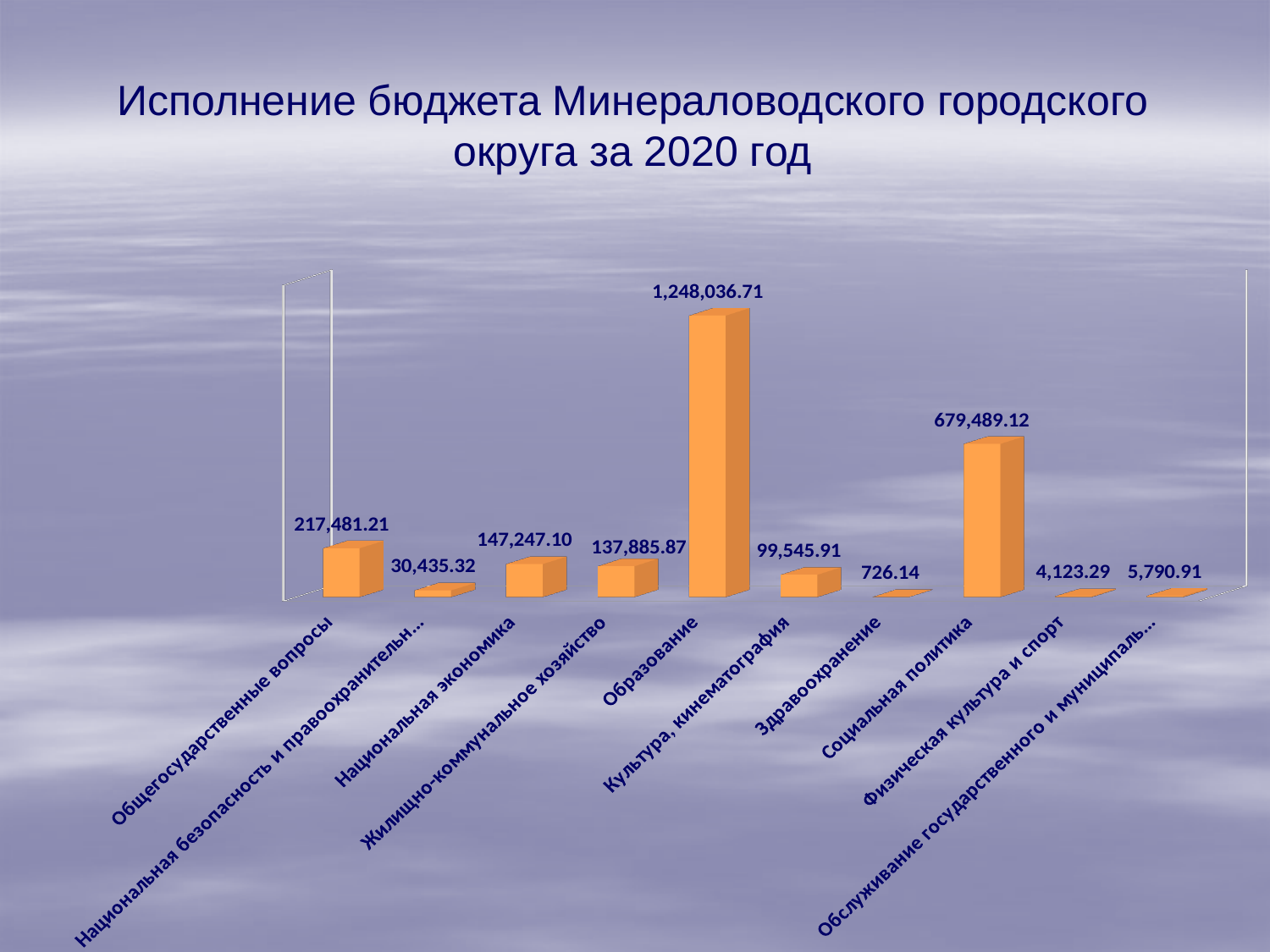
What is the value for Жилищно-коммунальное хозяйство? 137,885.87 What is the difference between the values for Образование and Социальная политика? 568,547.59 Which category has the lowest value? Здравоохранение What is the value for Образование? 1,248,036.71 What is the value for Социальная политика? 679,489.12 What is the value for Здравоохранение? 726.14 Which category has the highest value? Образование What is the difference between the values for Национальная экономика and Жилищно-коммунальное хозяйство? 9,361.23 Which is larger, the value for Общегосударственные вопросы or the value for Культура, кинематография? Общегосударственные вопросы What kind of chart is shown on the slide? Bar chart What is the title of the slide? Исполнение бюджета Минераловодского городского округа за 2020 год How many categories are shown in the chart? 10